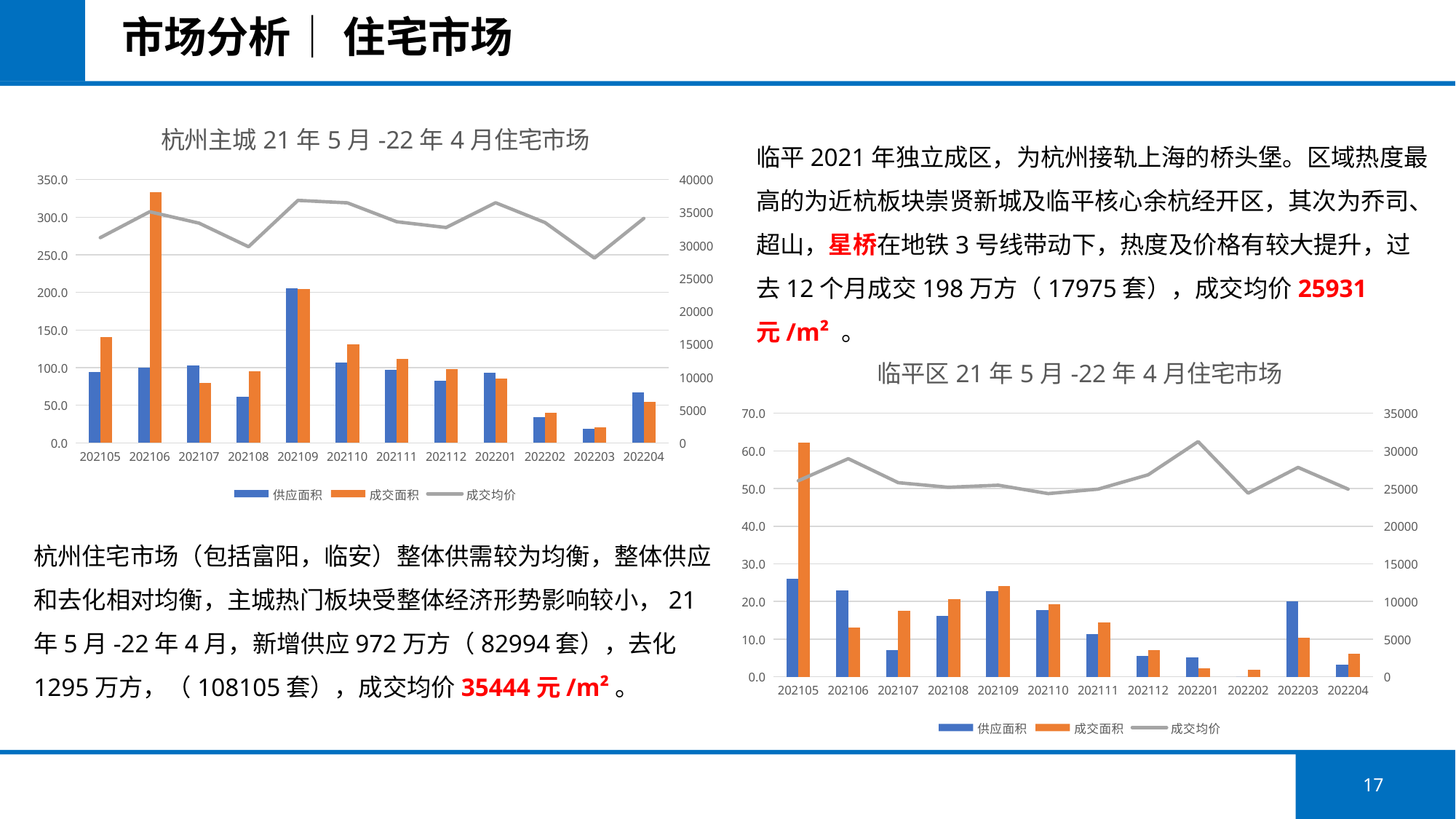
In the chart titled 杭州主城 21 年 5 月 -22 年 4 月住宅市场, does the 成交面积 rise or fall from 202109 to 202203? fall In the chart titled 杭州主城 21 年 5 月 -22 年 4 月住宅市场, how many months are shown on the x axis? 12 In the chart titled 杭州主城 21 年 5 月 -22 年 4 月住宅市场, which month has the lowest 供应面积? 202203 In the chart titled 杭州主城 21 年 5 月 -22 年 4 月住宅市场, is the 成交面积 for 202106 greater or less than 300? greater In the chart titled 杭州主城 21 年 5 月 -22 年 4 月住宅市场, is the 成交均价 for 202109 greater or less than 35000? greater In the chart titled 杭州主城 21 年 5 月 -22 年 4 月住宅市场, which month has the highest 成交面积? 202106 In the chart titled 临平区 21 年 5 月 -22 年 4 月住宅市场, is the 成交面积 for 202105 greater or less than 50? greater In the chart titled 临平区 21 年 5 月 -22 年 4 月住宅市场, which month has the lowest 成交面积? 202202 In the chart titled 临平区 21 年 5 月 -22 年 4 月住宅市场, which month has the highest 成交面积? 202105 In the chart titled 临平区 21 年 5 月 -22 年 4 月住宅市场, which is larger, the 供应面积 for 202203 or for 202112? 202203 In the chart titled 临平区 21 年 5 月 -22 年 4 月住宅市场, how many series does the legend list? 3 In the chart titled 杭州主城 21 年 5 月 -22 年 4 月住宅市场, which is larger, the 供应面积 for 202109 or for 202110? 202109